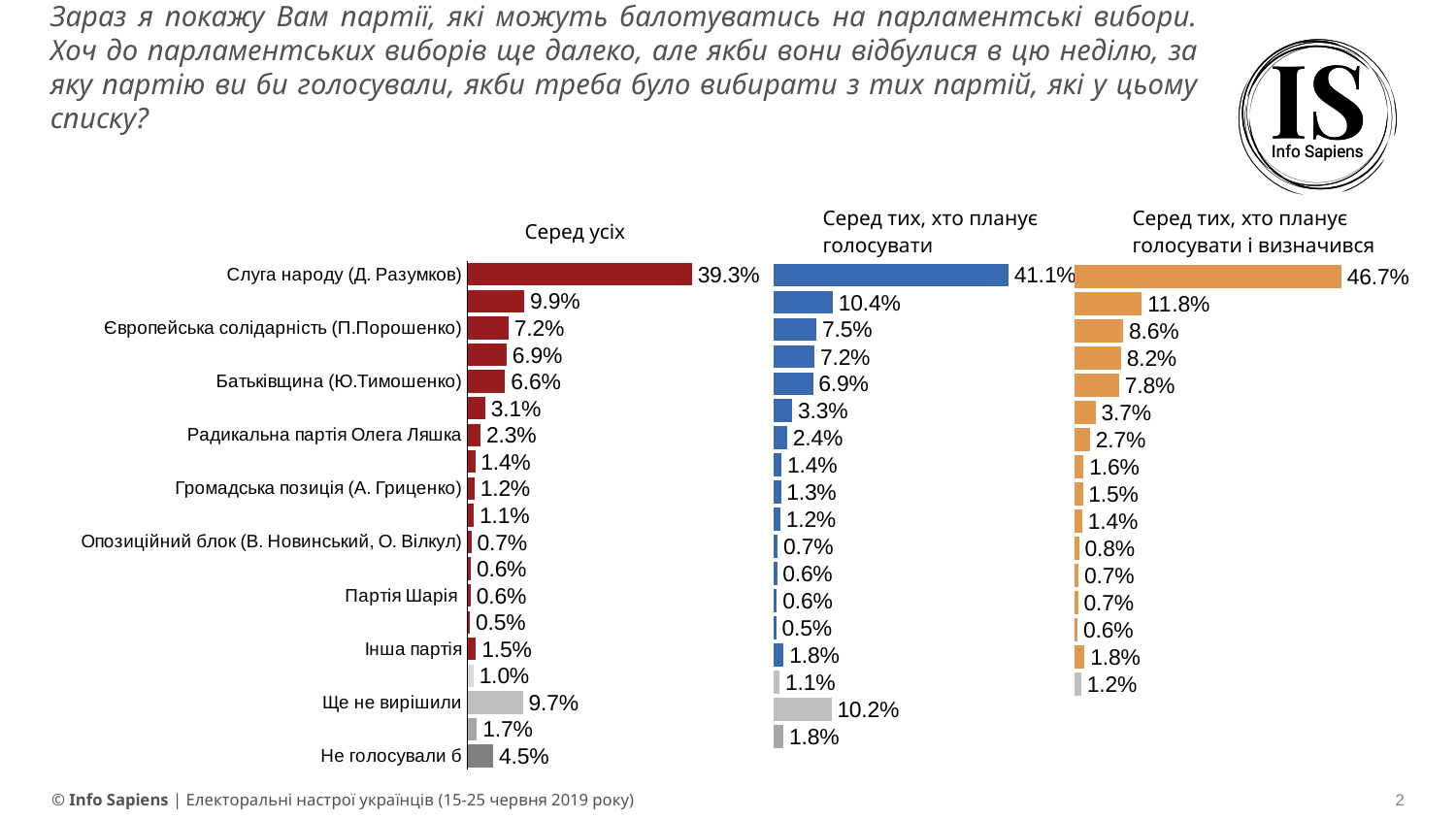
In the "Серед тих, хто планує голосувати" chart, what is the value for Ще не вирішили? 10.2% What is the difference between the value for Слуга народу (Д. Разумков) in the "Серед тих, хто планує голосувати і визначився" chart and in the "Серед усіх" chart? 7.4% In the "Серед усіх" chart, what is the value for Слуга народу (Д. Разумков)? 39.3% In the "Серед тих, хто планує голосувати" chart, what is the value for Батьківщина (Ю.Тимошенко)? 6.9% In the "Серед тих, хто планує голосувати і визначився" chart, which is larger: Радикальна партія Олега Ляшка or Громадська позиція (А. Гриценко)? Радикальна партія Олега Ляшка In the "Серед усіх" chart, what is the difference between Європейська солідарність (П.Порошенко) and Батьківщина (Ю.Тимошенко)? 0.6% In the "Серед усіх" chart, which category has the highest value? Слуга народу (Д. Разумков) In the "Серед усіх" chart, what is the value for Не голосували б? 4.5% How many bars are plotted in the "Серед усіх" chart? 19 What type of chart is used on this slide? Bar chart In the "Серед тих, хто планує голосувати і визначився" chart, what is the value for Слуга народу (Д. Разумков)? 46.7% What colour are the bars in the "Серед тих, хто планує голосувати" chart? Blue (the last two bars, for undecided and don't know/refusal, are grey)